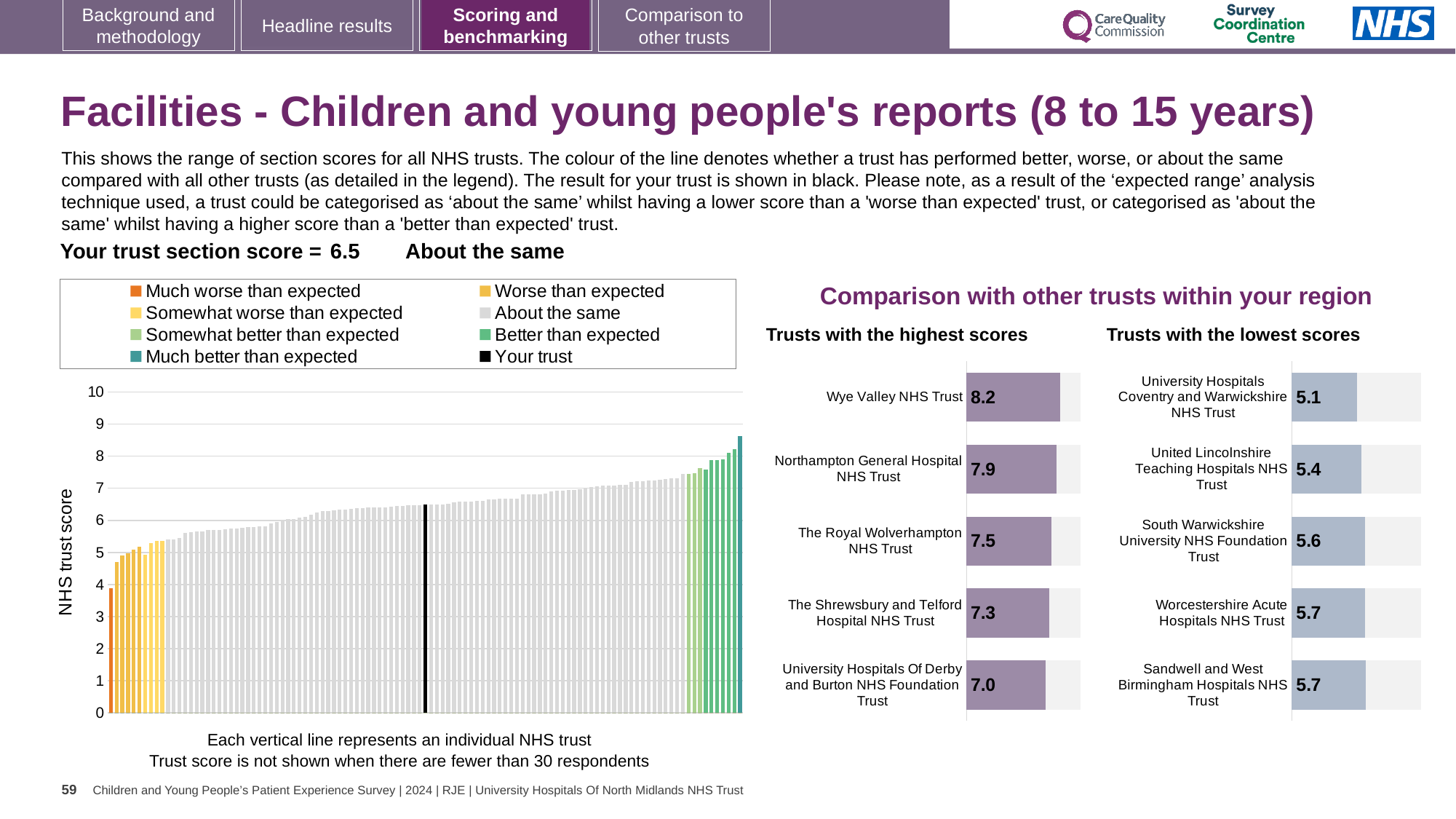
In the 'Trusts with the highest scores' chart, what is the score for The Royal Wolverhampton NHS Trust? 7.5 How many trusts are shown in the 'Trusts with the lowest scores' chart? 5 In the 'Trusts with the highest scores' chart, what is the difference between the scores of Wye Valley NHS Trust and University Hospitals Of Derby and Burton NHS Foundation Trust? 1.2 In the 'Trusts with the highest scores' chart, which trust has the highest score? Wye Valley NHS Trust In the 'Trusts with the highest scores' chart, what is the score for Wye Valley NHS Trust? 8.2 In the 'Trusts with the lowest scores' chart, what is the score for United Lincolnshire Teaching Hospitals NHS Trust? 5.4 Which has a higher score: Northampton General Hospital NHS Trust in the highest scores chart, or South Warwickshire University NHS Foundation Trust in the lowest scores chart? Northampton General Hospital NHS Trust How many categories does the legend above the main 'NHS trust score' chart list? 8 In the 'Trusts with the lowest scores' chart, which trust has the lowest score? University Hospitals Coventry and Warwickshire NHS Trust In the main 'NHS trust score' chart on the left, do the trust scores rise or fall from left to right? rise In the main 'NHS trust score' chart on the left, what is the score for your trust (the black line)? 6.5 In the 'Trusts with the lowest scores' chart, what is the difference between the scores of Worcestershire Acute Hospitals NHS Trust and University Hospitals Coventry and Warwickshire NHS Trust? 0.6